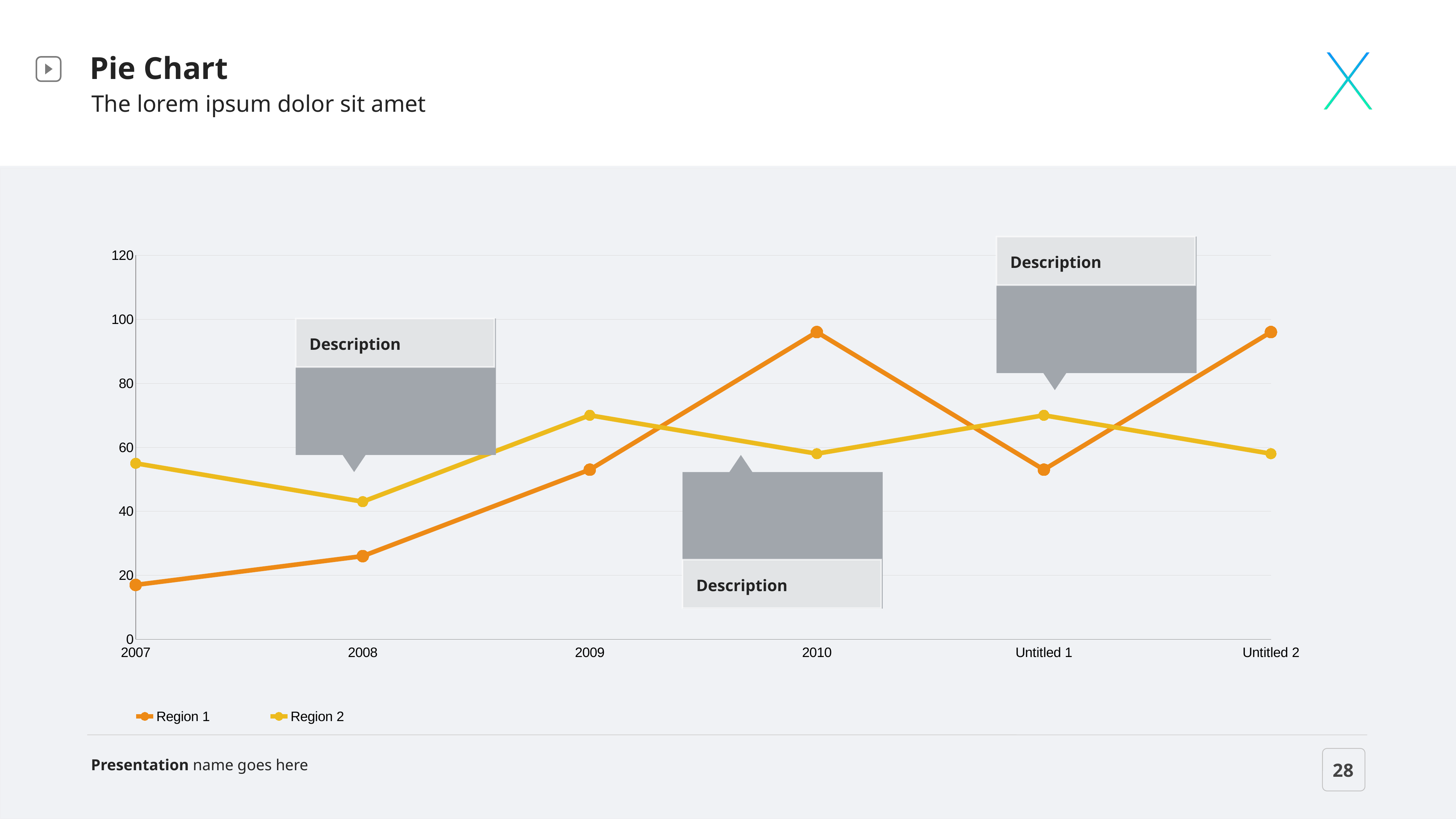
Is the value for Region 2 in 2009 greater or less than 60? greater Which series does the orange line represent? Region 1 In 2010, which series has the larger value, Region 1 or Region 2? Region 1 Is the value for Region 1 in 2007 greater or less than 40? less Is the value for Region 1 in 2010 greater or less than 80? greater What is the title printed above the chart on the slide? Pie Chart For Region 1, does the value rise or fall from 2007 to 2010? rise In 2007, which series has the larger value, Region 1 or Region 2? Region 2 How many categories are shown along the x axis? 6 How many series does the legend list? 2 What kind of chart is shown on the slide? line chart